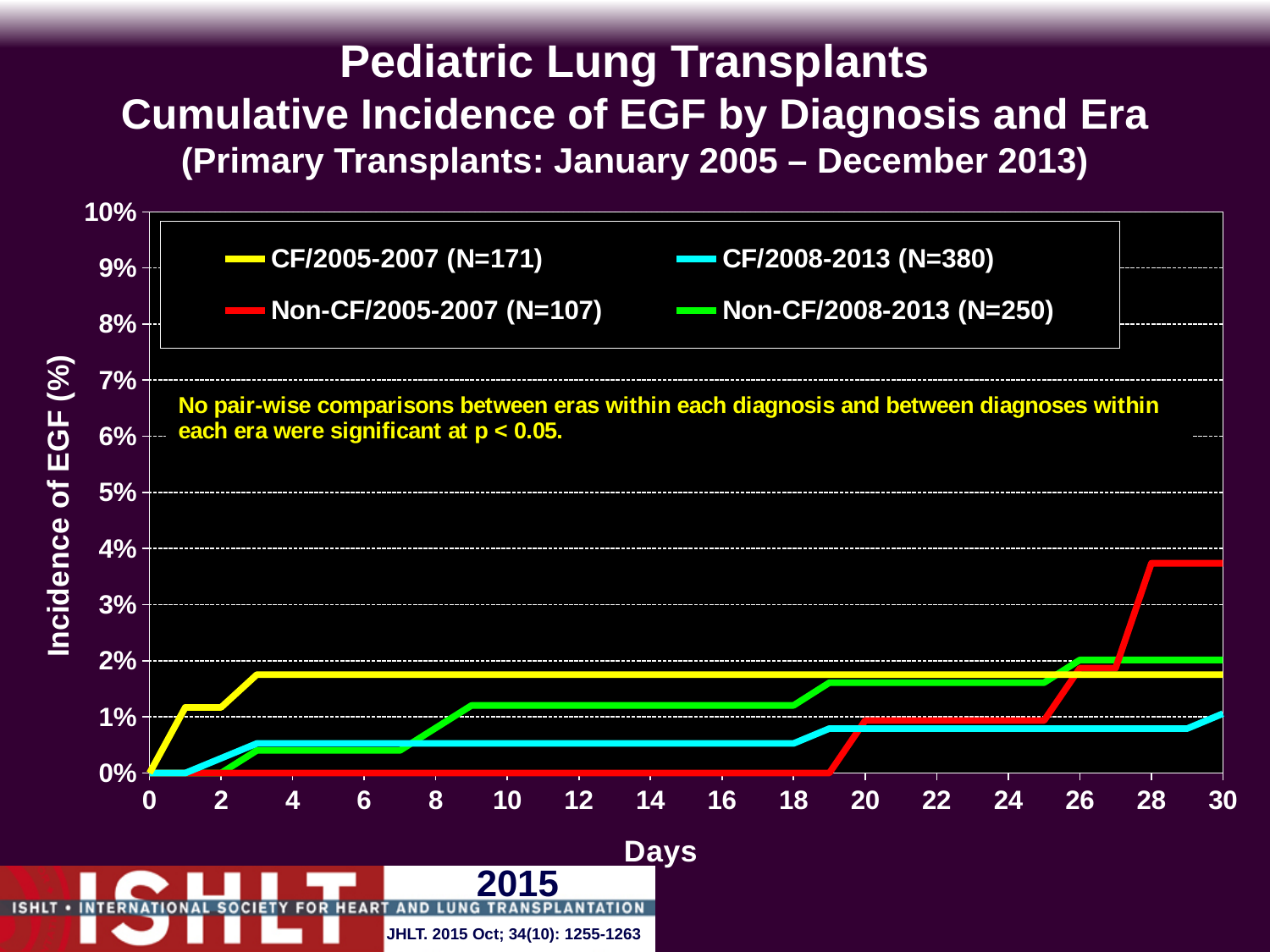
What is the N for the CF/2008-2013 series shown in the legend? 380 What kind of chart is shown on the slide? Line chart Is the value for Non-CF/2005-2007 at day 10 greater or less than 1%? less Is the value for Non-CF/2008-2013 at day 22 greater or less than 1%? greater Is the value for Non-CF/2005-2007 at day 30 greater or less than 3%? greater Do the cumulative incidence values rise or fall as days increase along the x axis? Rise At day 30, which is larger: the value for Non-CF/2005-2007 or the value for CF/2008-2013? Non-CF/2005-2007 Which series has the lowest cumulative incidence of EGF at day 30? CF/2008-2013 (N=380) Which series has the highest cumulative incidence of EGF at day 30? Non-CF/2005-2007 (N=107) How many series does the legend list? 4